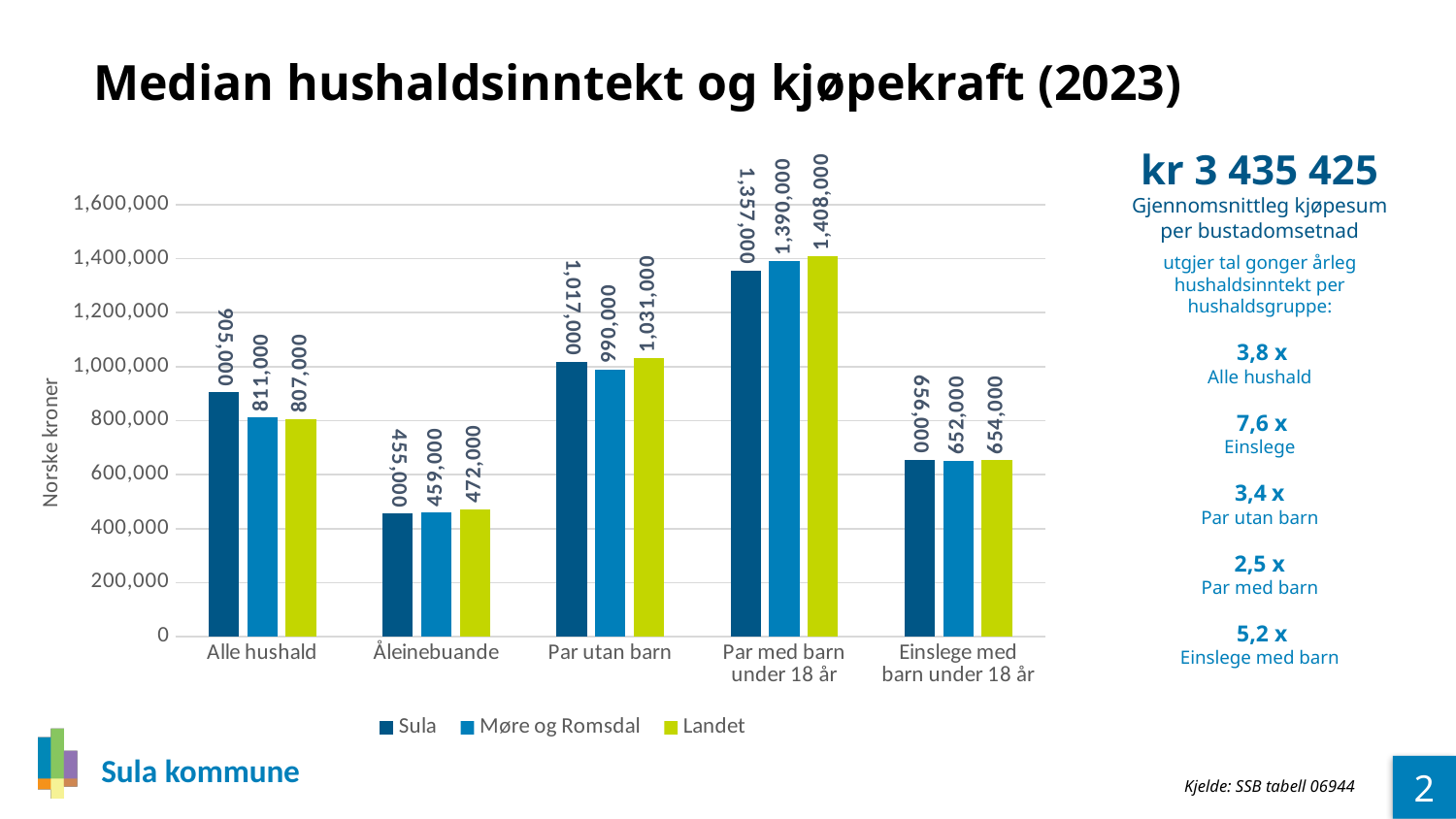
Which category has the highest value for Sula? Par med barn under 18 år What kind of chart is shown on the slide? bar chart How many categories are shown on the x axis? 5 What is the value for Sula in the 'Alle hushald' category? 905,000 What is the difference between the Sula and Møre og Romsdal values in the 'Alle hushald' category? 94,000 Is the value for Sula in the 'Åleinebuande' category greater or less than 600,000? less What is the value for Møre og Romsdal in the 'Par utan barn' category? 990,000 What is the value for Landet in the 'Par med barn under 18 år' category? 1,408,000 In the 'Par med barn under 18 år' category, which is larger: the value for Sula or the value for Landet? Landet How many series does the legend list? 3 Which category has the lowest value for Landet? Åleinebuande What is the label of the y axis? Norske kroner